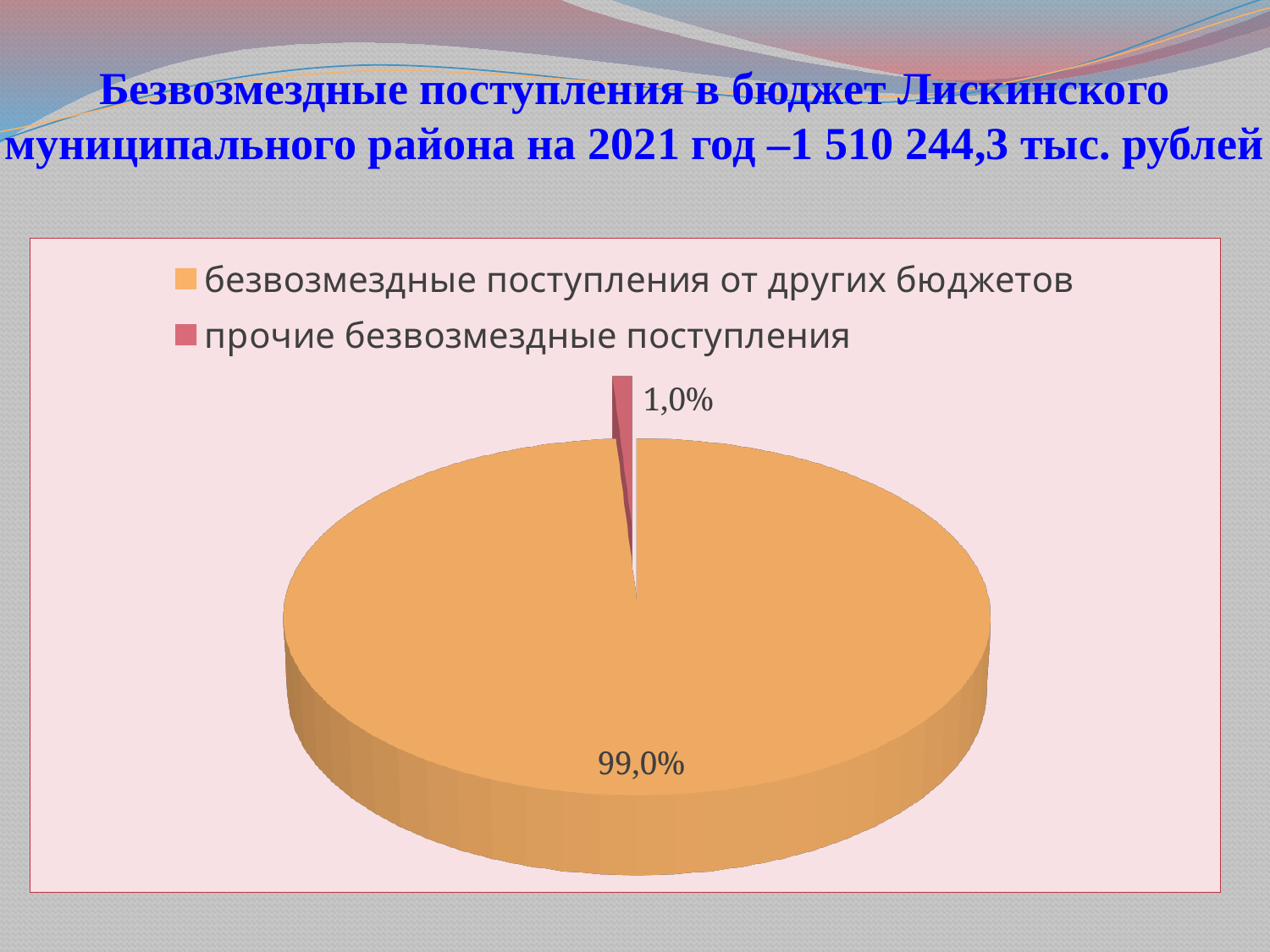
What kind of chart is shown on the slide? pie chart Which is larger: the slice for "прочие безвозмездные поступления" or the slice for "безвозмездные поступления от других бюджетов"? безвозмездные поступления от других бюджетов How many slices does the pie chart have? 2 Which category has the largest slice of the pie? безвозмездные поступления от других бюджетов What share of the pie does "безвозмездные поступления от других бюджетов" have? 99,0% How many entries does the legend list? 2 What is the difference in percentage points between the two slices of the pie? 98,0% What share of the pie does "прочие безвозмездные поступления" have? 1,0% What colour is the slice for "прочие безвозмездные поступления"? red What total amount of gratuitous receipts for 2021 is stated in the slide title? 1 510 244,3 тыс. рублей Which category has the smallest slice of the pie? прочие безвозмездные поступления